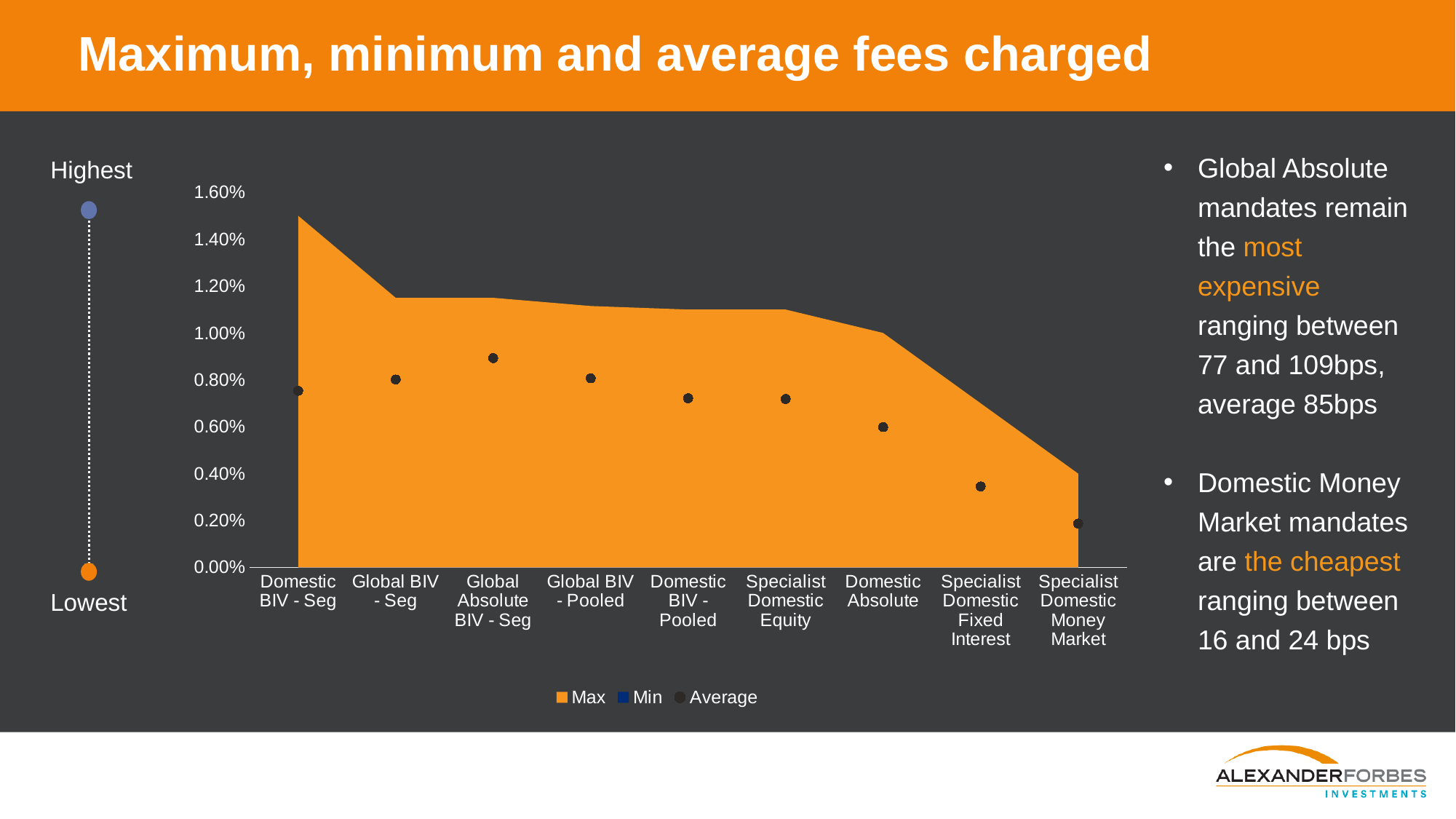
Is the Average fee for Global Absolute BIV - Seg greater or less than 0.80%? greater Do the Max fee values generally rise or fall moving from left to right along the x axis? fall Which category has the lowest Max fee in the chart? Specialist Domestic Money Market How many categories are shown on the x axis of the chart? 9 What are the series names listed in the chart legend? Max, Min, Average Which category has the highest Average fee in the chart? Global Absolute BIV - Seg Is the Max fee for Specialist Domestic Money Market greater or less than 0.60%? less Which has the larger Average fee: Global Absolute BIV - Seg or Domestic BIV - Pooled? Global Absolute BIV - Seg Is the Max fee for Domestic BIV - Seg greater or less than 1.40%? greater Which category has the lowest Average fee in the chart? Specialist Domestic Money Market Which category has the highest Max fee in the chart? Domestic BIV - Seg How many series does the chart legend list? 3